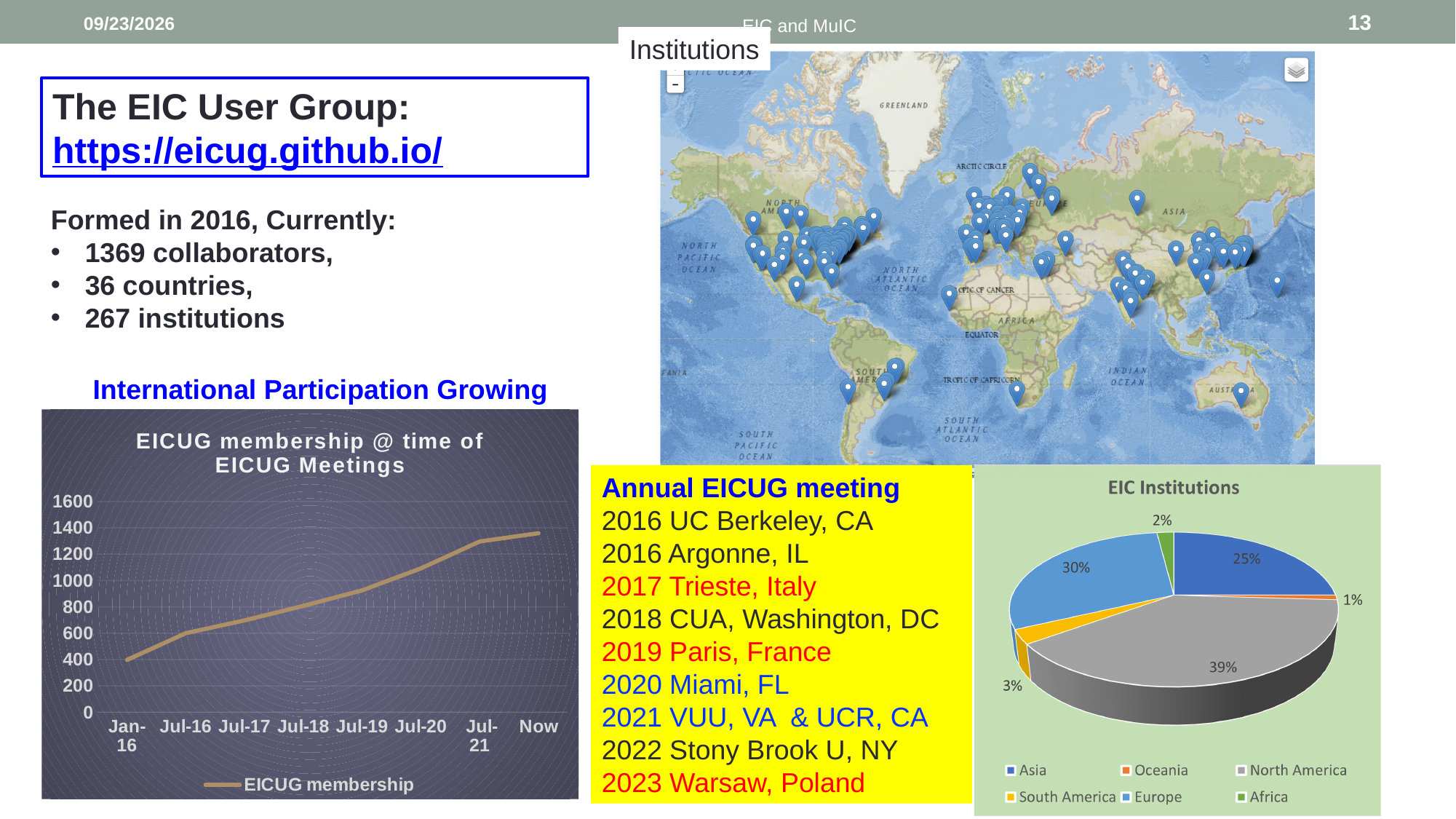
In the EIC Institutions pie chart, which region has the smallest share? Oceania In the EIC Institutions pie chart, what share of institutions is in North America? 39% What kind of chart is the 'EICUG membership @ time of EICUG Meetings' chart? line chart In the 'EICUG membership @ time of EICUG Meetings' chart, is the value for Jul-21 greater or less than 1200? greater In the EIC Institutions pie chart, what is the difference in percentage points between North America and Europe? 9 In the EIC Institutions pie chart, which region has the largest share? North America In the EIC Institutions pie chart, what share of institutions is in Asia? 25% In the 'EICUG membership @ time of EICUG Meetings' chart, does membership rise or fall from Jan-16 to Now? rise In the EIC Institutions pie chart, what share of institutions is in Europe? 30% In the 'EICUG membership @ time of EICUG Meetings' chart, is the value for Jan-16 greater or less than 600? less In the EIC Institutions pie chart, which has a larger share, South America or Africa? South America How many regions does the legend of the EIC Institutions pie chart list? 6